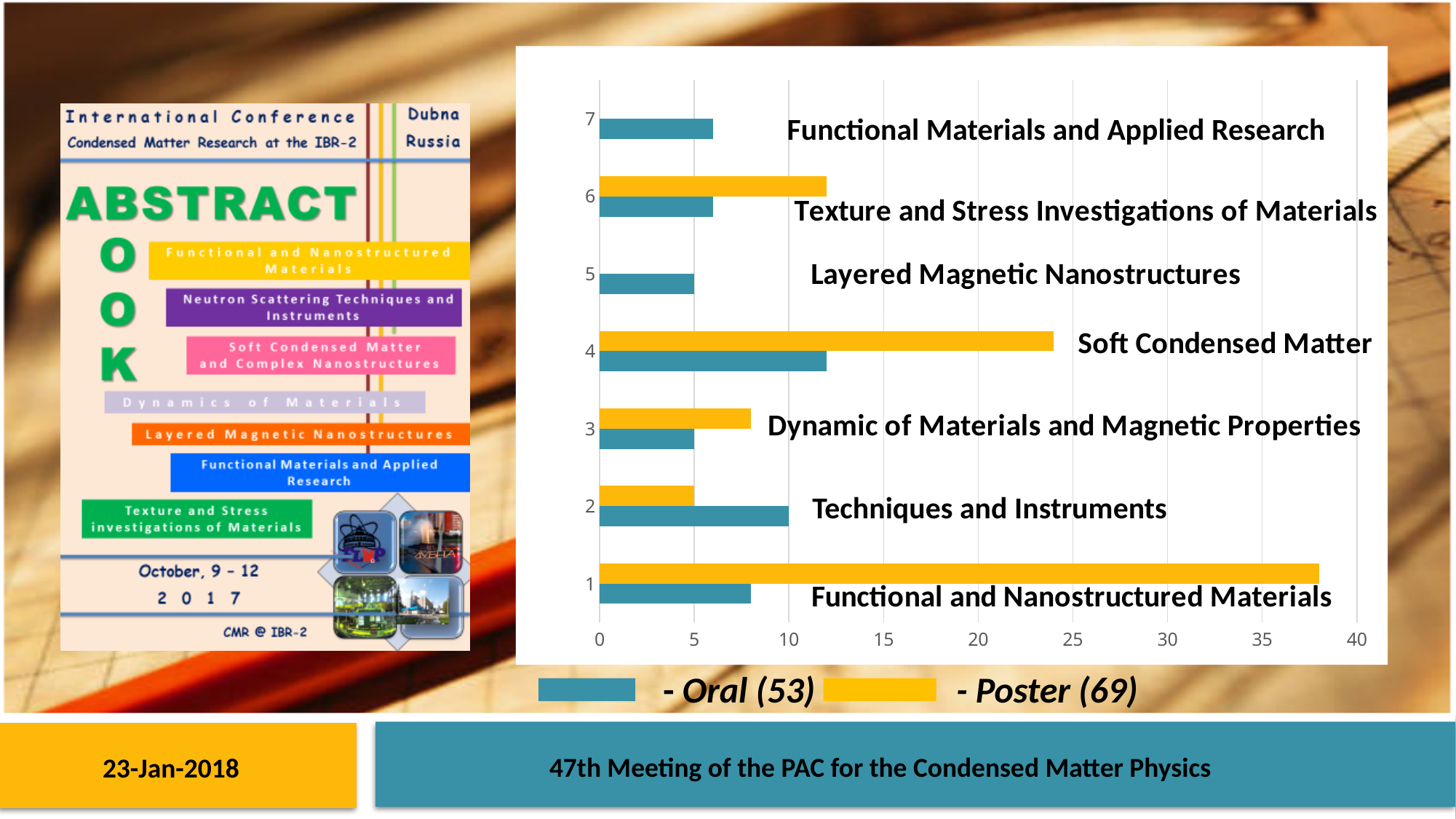
Which topic has the longest Oral bar? Soft Condensed Matter Is the Poster value for Soft Condensed Matter greater or less than 20? greater How many categories (topics) are plotted on the chart? 7 Is the Poster value for Functional and Nanostructured Materials greater or less than 35? greater According to the legend, what is the total number of Poster contributions? 69 How many series does the chart's legend list? 2 Is the Oral value for Soft Condensed Matter greater or less than 10? greater Which topic has the longest Poster bar? Functional and Nanostructured Materials For Functional and Nanostructured Materials, which is larger: the Oral bar or the Poster bar? Poster What kind of chart is shown on the slide? bar chart For Techniques and Instruments, which is larger: the Oral bar or the Poster bar? Oral